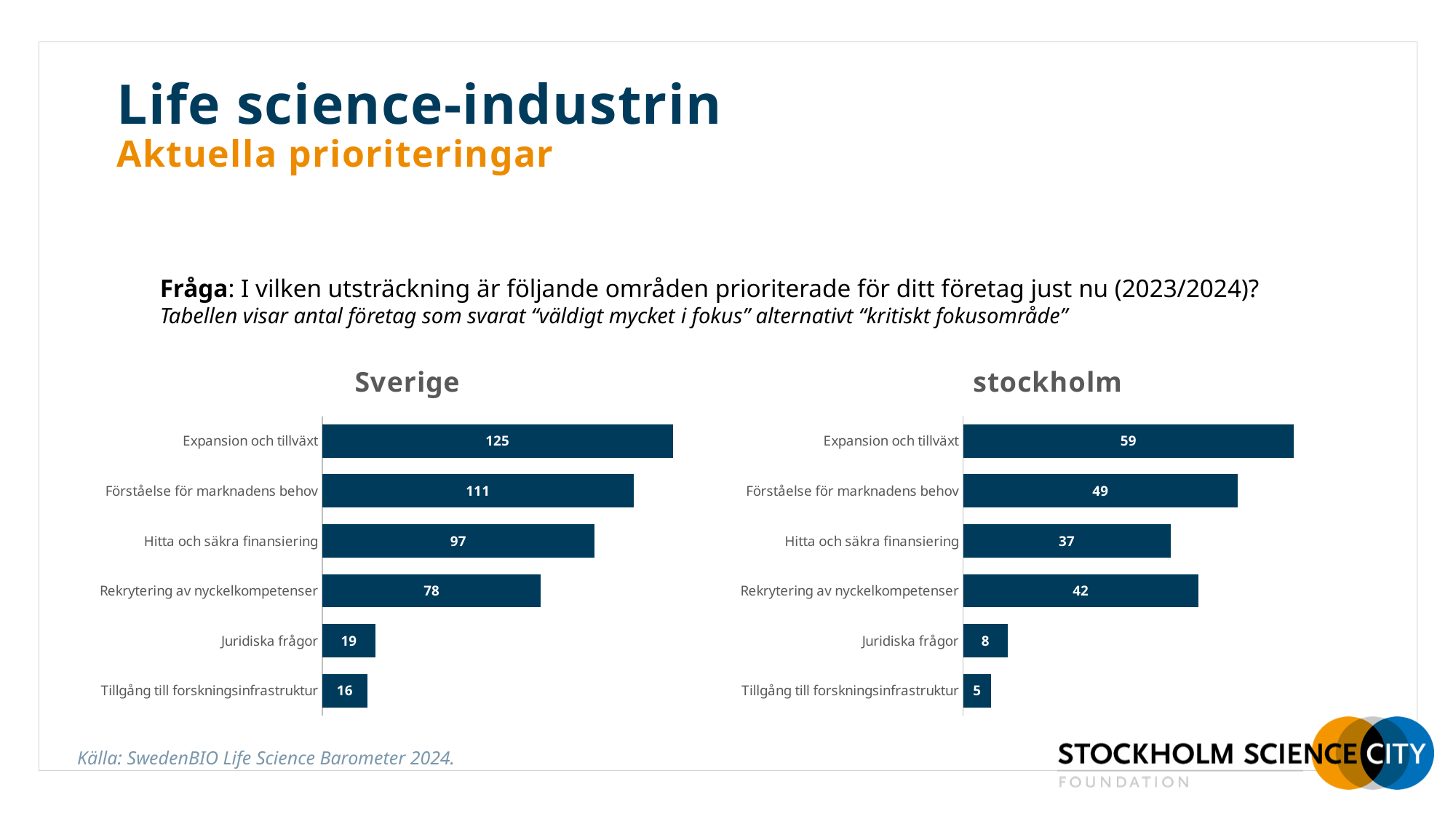
In the stockholm chart, which is larger: Hitta och säkra finansiering or Rekrytering av nyckelkompetenser? Rekrytering av nyckelkompetenser What is the source cited at the bottom of the slide? SwedenBIO Life Science Barometer 2024 In the stockholm chart, which category has the highest value? Expansion och tillväxt In the stockholm chart, which category has the lowest value? Tillgång till forskningsinfrastruktur In the Sverige chart, what is the value for Expansion och tillväxt? 125 How many categories does the Sverige chart show? 6 In the Sverige chart, what is the difference between Expansion och tillväxt and Förståelse för marknadens behov? 14 In the Sverige chart, which category has the lowest value? Tillgång till forskningsinfrastruktur In the Sverige chart, what is the value for Juridiska frågor? 19 What kind of chart is the stockholm chart? Bar chart In the stockholm chart, what is the difference between Rekrytering av nyckelkompetenser and Hitta och säkra finansiering? 5 In the stockholm chart, what is the value for Rekrytering av nyckelkompetenser? 42